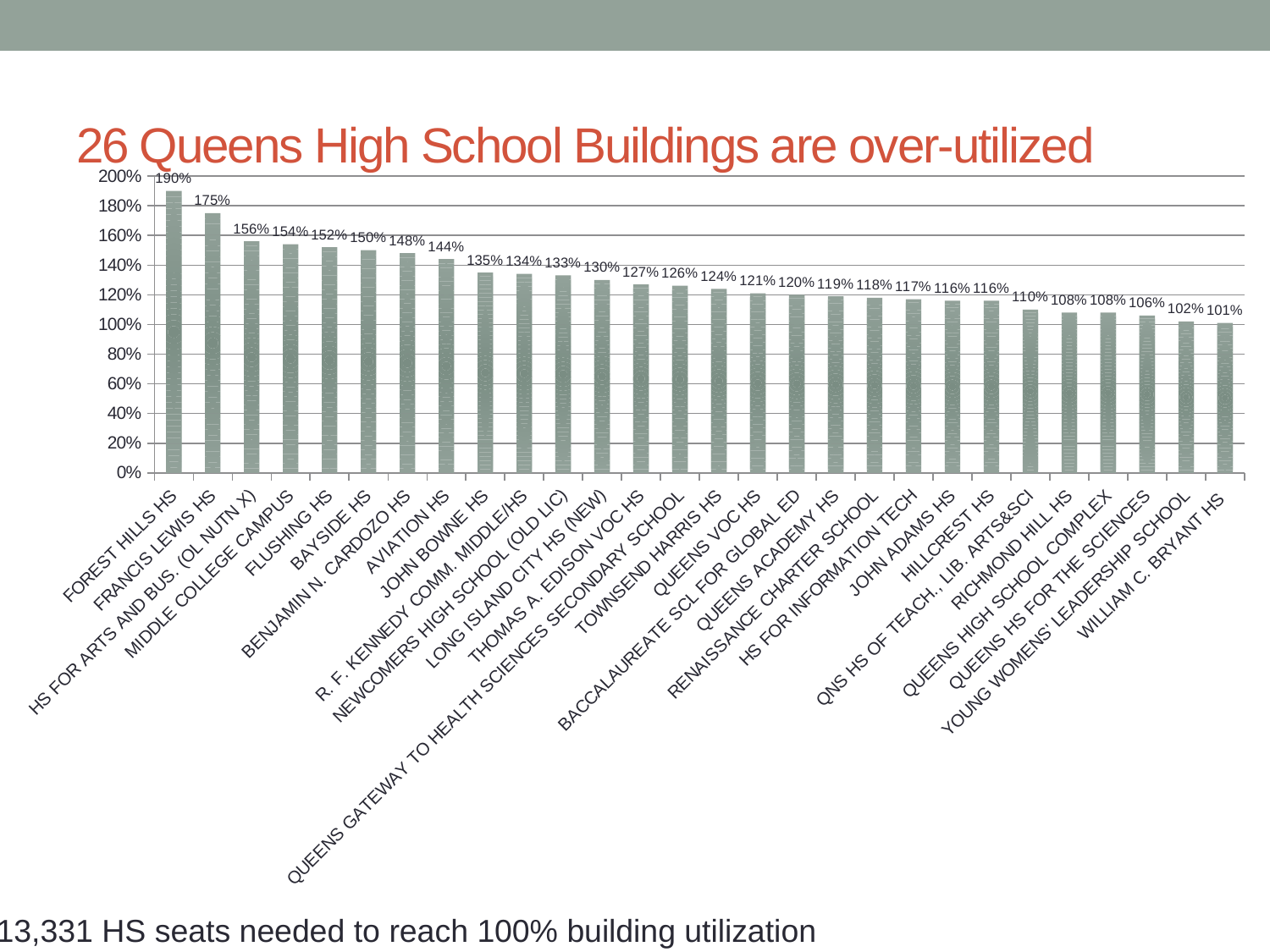
How many school buildings are plotted in the chart? 28 Which school building has the highest utilization? FOREST HILLS HS Which has a higher utilization, Bayside HS or Aviation HS? BAYSIDE HS What is the utilization value for Forest Hills HS? 190% What is the utilization value for Flushing HS? 152% Which school building has the lowest utilization shown? WILLIAM C. BRYANT HS What is the difference in utilization between Forest Hills HS and Francis Lewis HS? 15% Is the value for John Bowne HS greater or less than 140%? less What type of chart is shown on the slide? Bar chart Do the values rise or fall from left to right along the x axis? Fall What is the utilization value for Townsend Harris HS? 124% What is the utilization value for William C. Bryant HS? 101%